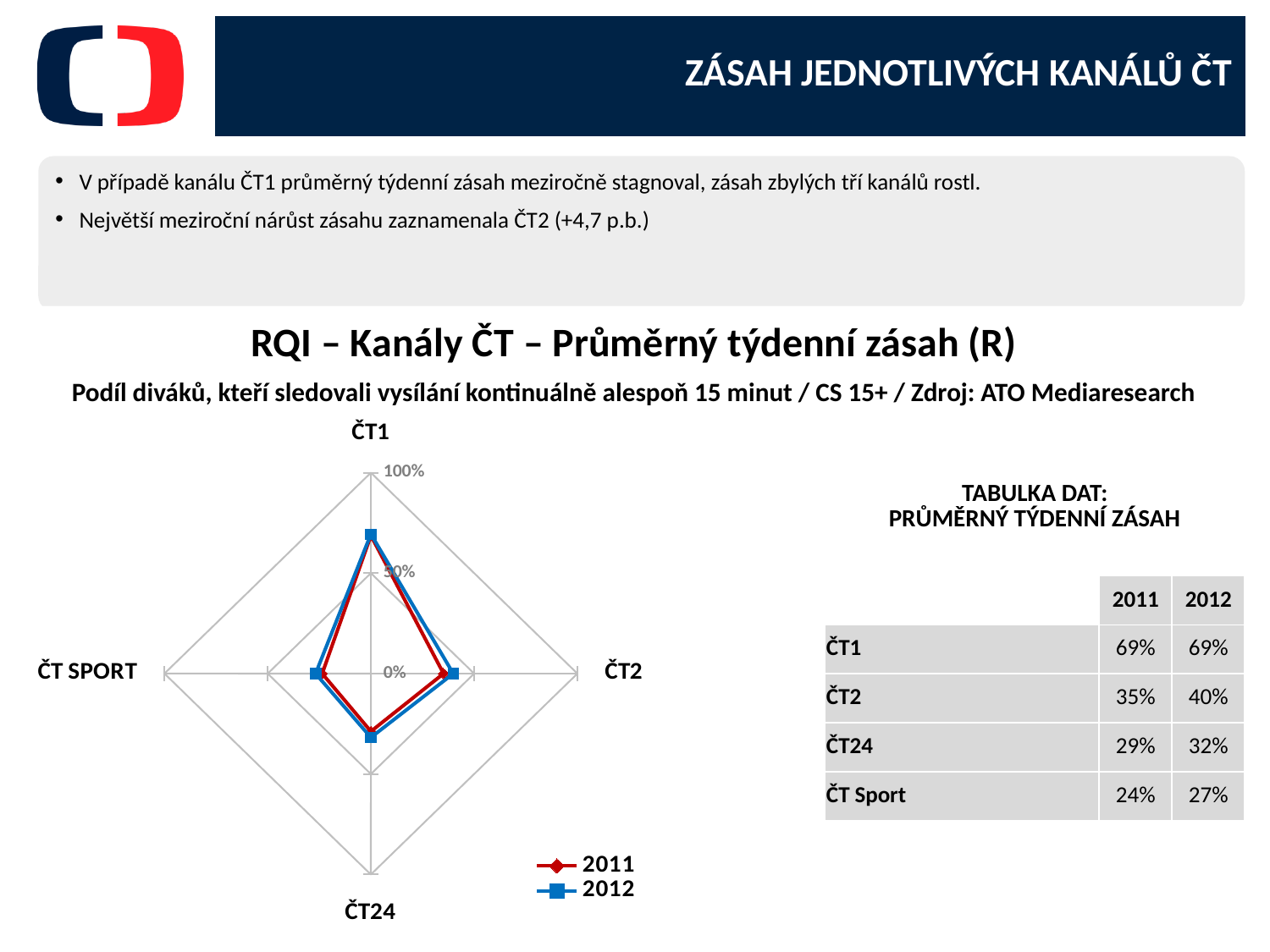
Is the value for ČT1 in 2012 greater or less than 50%? greater Which channel had the lowest average weekly reach in 2011? ČT Sport According to the data table, what was the average weekly reach of ČT2 in 2012? 40% By how many percentage points did the reach of ČT2 change from 2011 to 2012? +4.7 percentage points (+4,7 p.b.) Which channel had the highest average weekly reach in 2012? ČT1 What kind of chart is shown on the slide? radar chart Which was larger in 2012: the reach of ČT24 or the reach of ČT Sport? ČT24 How many categories (channels) are plotted on the radar chart? 4 Which colour represents the 2012 series on the radar chart? blue According to the data table, what was the average weekly reach of ČT24 in 2012? 32% How many series does the chart legend list? 2 According to the data table, what was the average weekly reach of ČT Sport in 2011? 24%